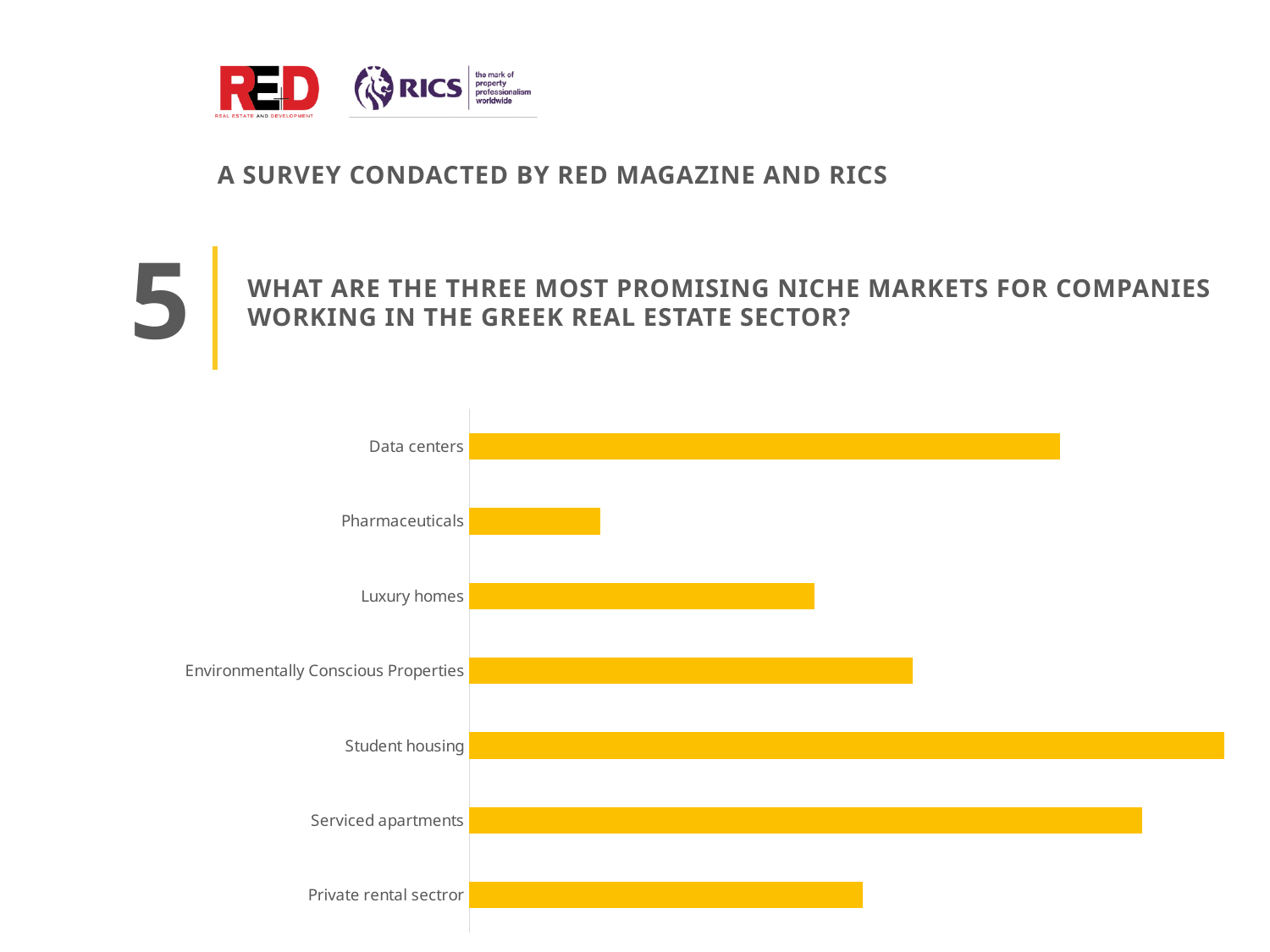
Which category is listed at the top of the chart? Data centers Which has the larger value, Data centers or Environmentally Conscious Properties? Data centers Which has the larger value, Data centers or Luxury homes? Data centers Which niche market has the longest bar in the chart? Student housing What kind of chart is shown on the slide? bar chart What colour are the bars in the chart? yellow How many niche market categories are plotted in the chart? 7 Which has the larger value, Student housing or Luxury homes? Student housing Which niche market has the shortest bar in the chart? Pharmaceuticals